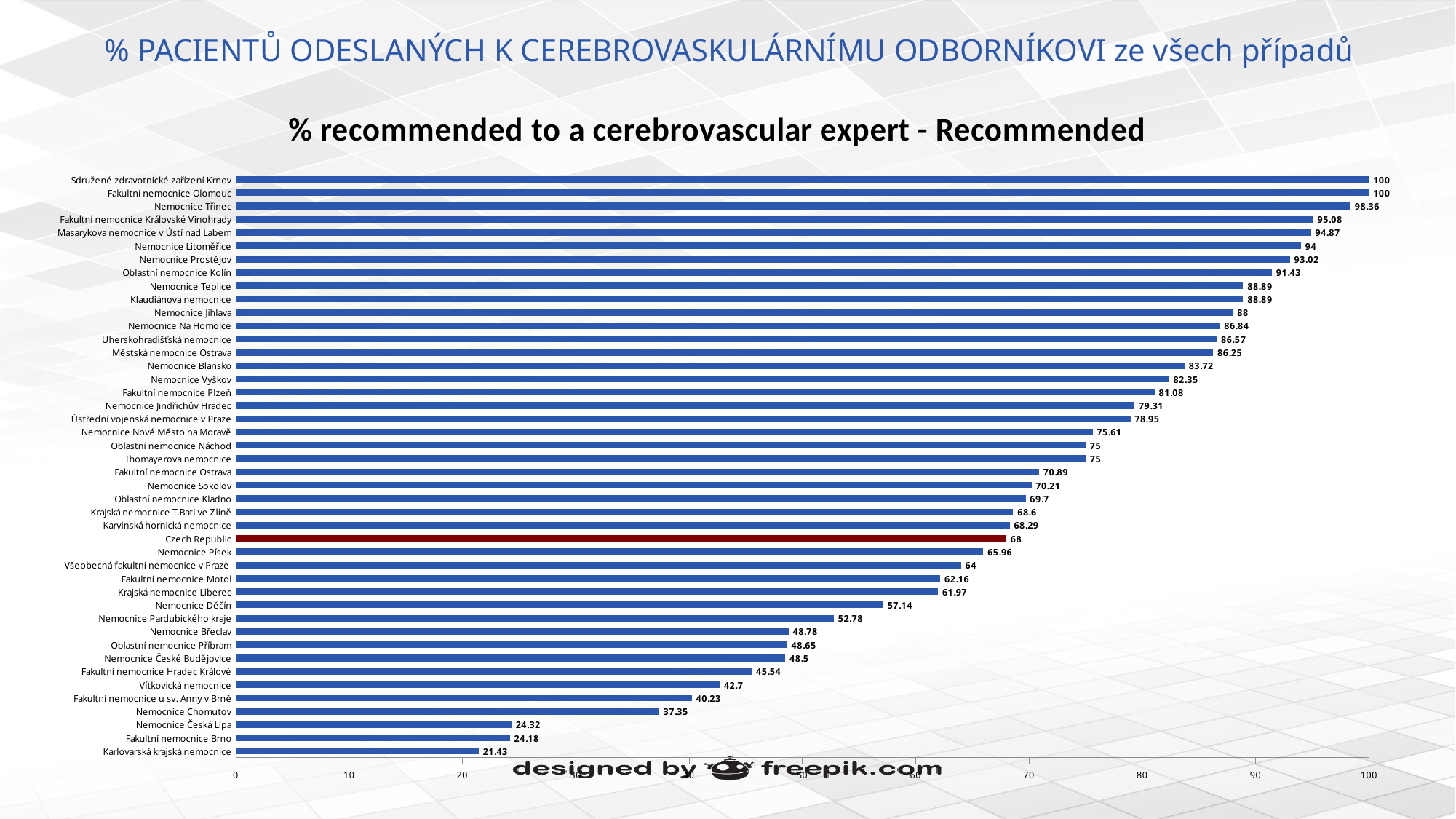
What is the value for Nemocnice Třinec? 98.36 Which has a larger value, Fakultní nemocnice Brno or Nemocnice Česká Lípa? Nemocnice Česká Lípa What is the value for Nemocnice Chomutov? 37.35 What is the highest value shown in the chart? 100 Is the value for Vítkovická nemocnice greater or less than 50? less What is the difference between the values for Nemocnice Děčín and Nemocnice Pardubického kraje? 4.36 Which category has the lowest value? Karlovarská krajská nemocnice Which bar is shown in a different colour (red) from the others? Czech Republic How many categories (bars) are shown in the chart? 44 What type of chart is shown on the slide? bar chart What is the value for Czech Republic? 68 What is the value for Fakultní nemocnice Motol? 62.16